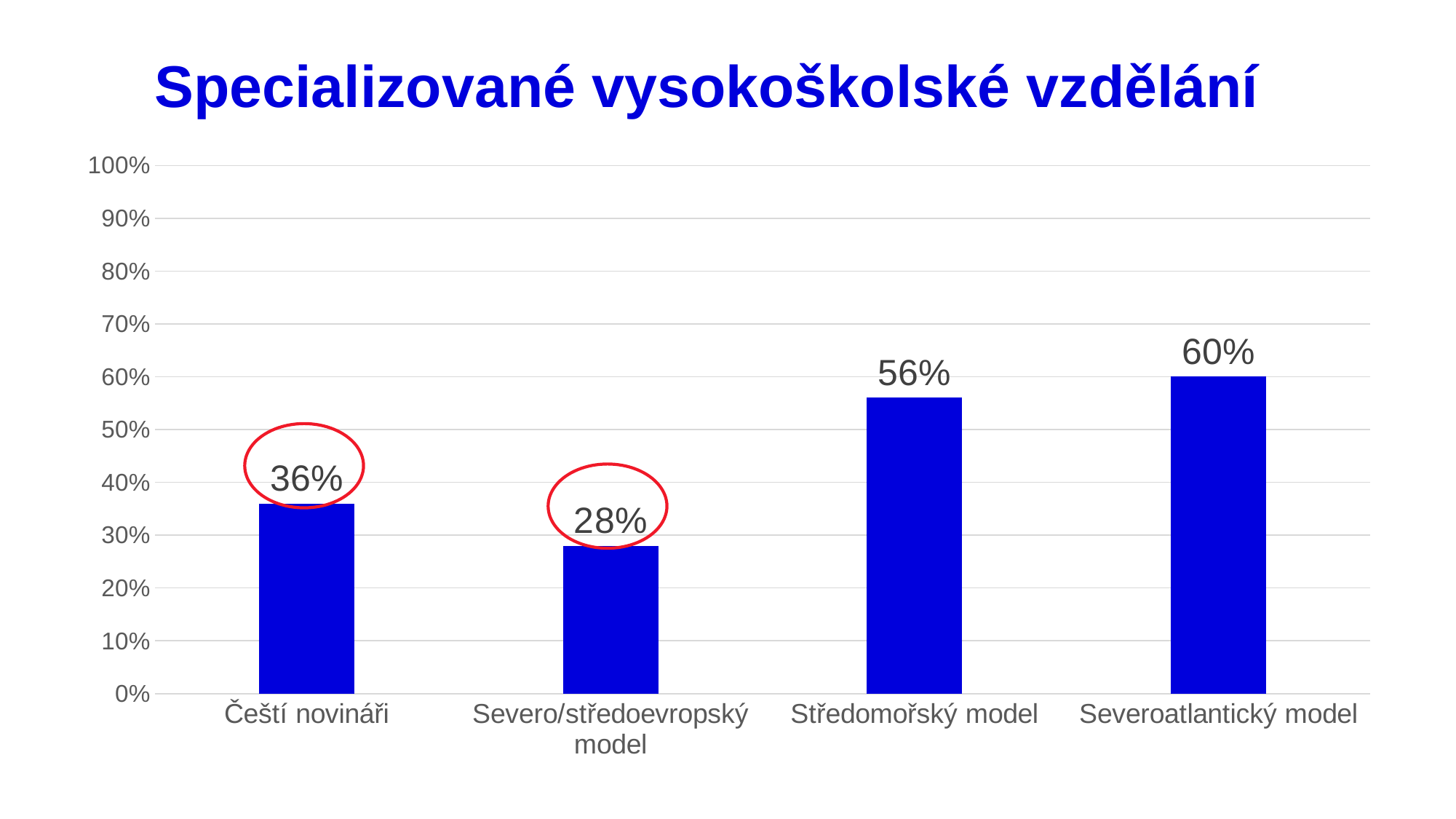
What is the difference between the values for Severoatlantický model and Čeští novináři? 24% How many categories are shown in the chart? 4 What kind of chart is shown on the slide? Bar chart Which category has the lowest value? Severo/středoevropský model Which category has the highest value? Severoatlantický model What is the title of the chart? Specializované vysokoškolské vzdělání What is the difference between the values for Středomořský model and Severo/středoevropský model? 28% What is the value for Čeští novináři? 36% What is the value for Středomořský model? 56% What is the value for Severoatlantický model? 60% What is the value for Severo/středoevropský model? 28% Which is larger, the value for Čeští novináři or the value for Severo/středoevropský model? Čeští novináři